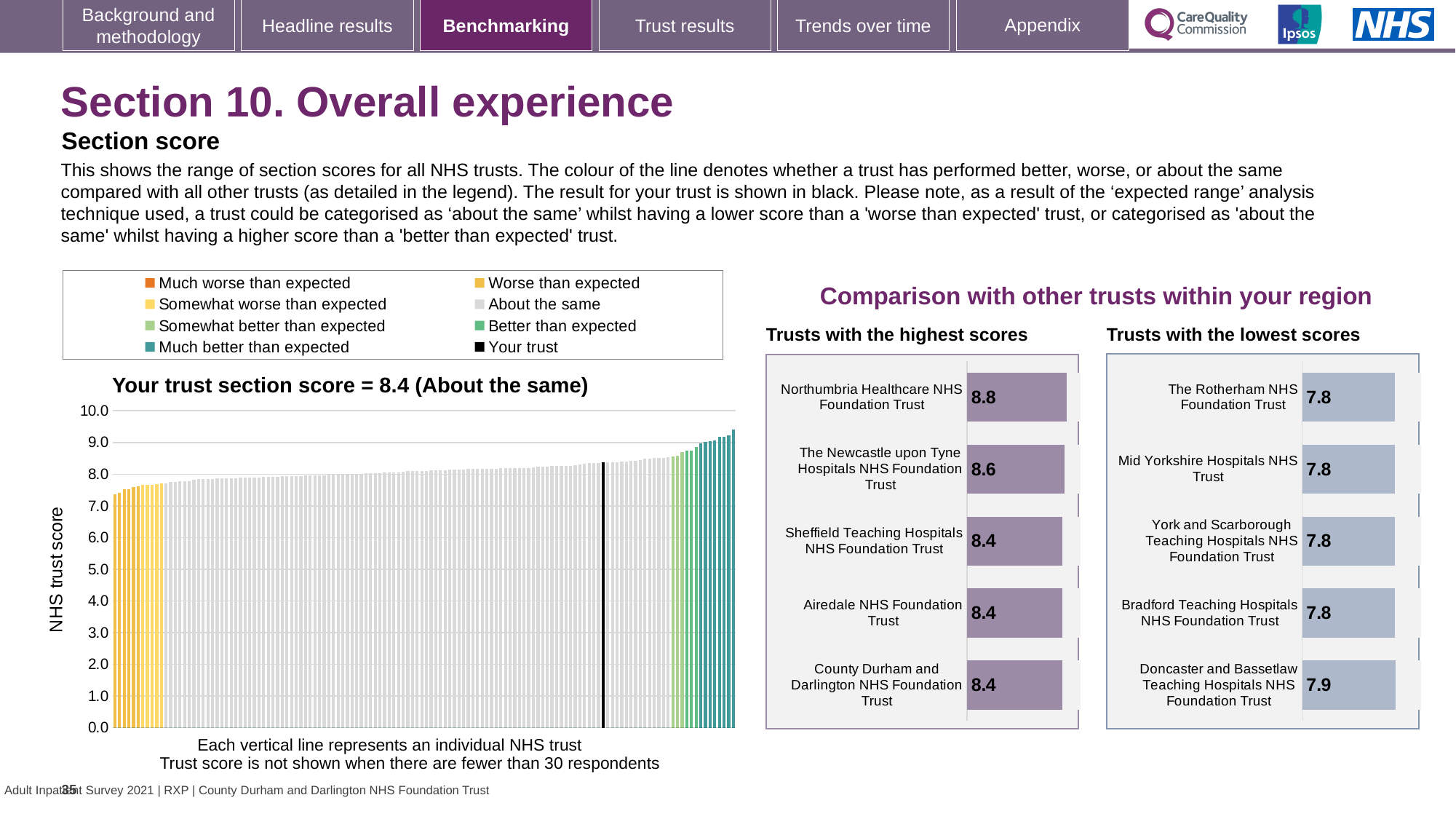
What is the y-axis label of the 'Your trust section score' chart? NHS trust score How many entries does the legend above the 'Your trust section score' chart list? 8 In the 'Your trust section score' chart, is the value of the rightmost bar greater or less than 9.0? greater In the 'Your trust section score' chart, what is the section score for your trust? 8.4 In the 'Trusts with the lowest scores' chart, what is the score for Doncaster and Bassetlaw Teaching Hospitals NHS Foundation Trust? 7.9 What kind of chart is the 'Your trust section score' chart on the left? bar chart In the 'Trusts with the highest scores' chart, which trust has the highest score? Northumbria Healthcare NHS Foundation Trust In the 'Your trust section score' chart, is the value of the leftmost bar greater or less than 8.0? less In the 'Trusts with the highest scores' chart, what is the difference between the scores of Northumbria Healthcare NHS Foundation Trust and The Newcastle upon Tyne Hospitals NHS Foundation Trust? 0.2 How many trusts are shown in the 'Trusts with the lowest scores' chart? 5 In the 'Your trust section score' chart, do the bars rise or fall from left to right? rise In the 'Trusts with the highest scores' chart, what is the score for Northumbria Healthcare NHS Foundation Trust? 8.8